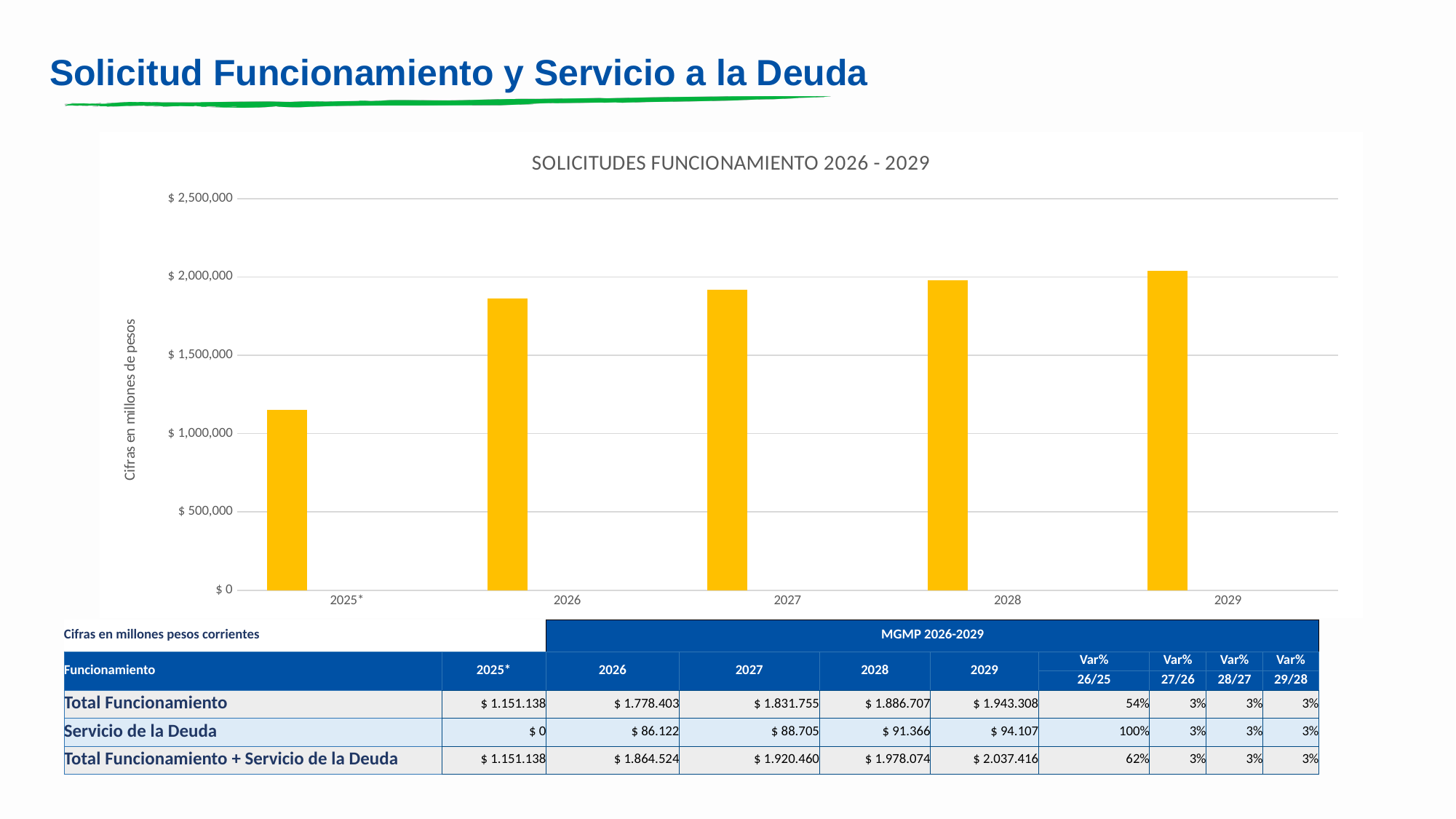
Is the value for 2025* greater or less than $ 1,500,000? less What is the title of the chart? SOLICITUDES FUNCIONAMIENTO 2026 - 2029 Is the value for 2026 greater or less than $ 2,000,000? less How many bars are plotted in the chart? 5 Is the value for 2025* greater or less than $ 1,000,000? greater Which year has the lowest bar in the chart? 2025* Which year has the highest bar in the chart? 2029 What kind of chart is shown on the slide? Bar chart Which is larger, the bar for 2025* or the bar for 2026? 2026 What is the label on the vertical axis of the chart? Cifras en millones de pesos Do the values generally rise or fall from 2025* to 2029? Rise